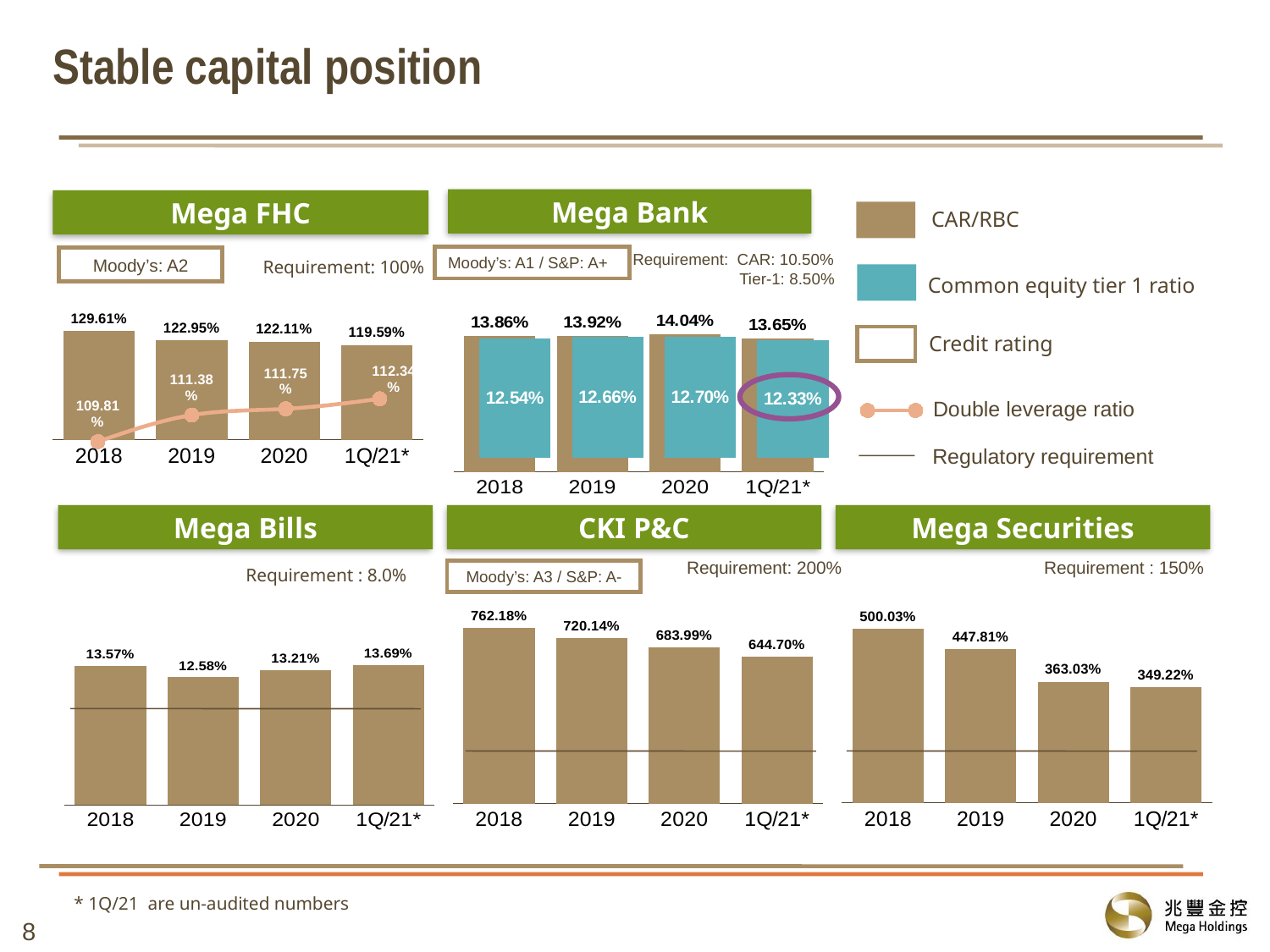
In the CKI P&C chart, what is the difference between the 2018 and 1Q/21* values? 117.48% In the Mega FHC chart, what is the double leverage ratio for 1Q/21*? 112.34% In the Mega Bills chart, is the value for 2020 larger or smaller than the value for 1Q/21*? smaller In the Mega FHC chart, what is the CAR/RBC value for 2018? 129.61% In the Mega Securities chart, what is the value for 2019? 447.81% In the Mega Bank chart, which year has the highest CAR/RBC value? 2020 How many periods are shown on the x axis of the Mega Securities chart? 4 In the Mega Bills chart, which year has the lowest value? 2019 In the CKI P&C chart, do the values rise or fall from 2018 to 1Q/21*? fall In the Mega Bank chart, what is the difference between the CAR/RBC values for 2020 and 1Q/21*? 0.39% In the Mega Bank chart, what is the common equity tier 1 ratio for 2020? 12.70% What type of chart is the CKI P&C chart? bar chart